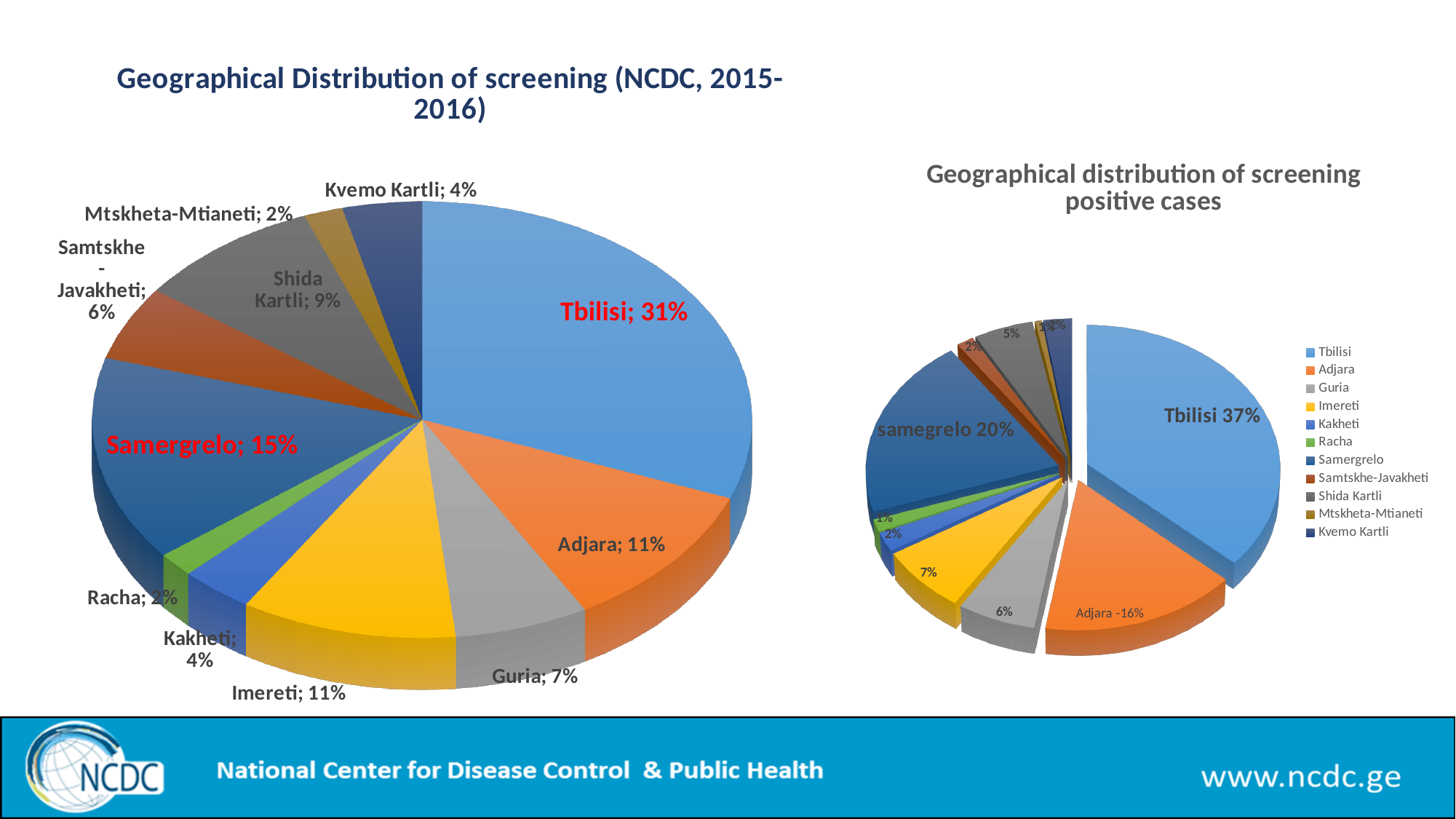
In the left chart, 'Geographical Distribution of screening (NCDC, 2015-2016)', which is larger: the share of Guria or the share of Samtskhe-Javakheti? Guria What kind of chart is the right chart, 'Geographical distribution of screening positive cases'? Pie chart In the left chart, 'Geographical Distribution of screening (NCDC, 2015-2016)', what share does Tbilisi have? 31% In the right chart, 'Geographical distribution of screening positive cases', what share does Tbilisi have? 37% How many entries does the legend of the right chart, 'Geographical distribution of screening positive cases', list? 11 In the left chart, 'Geographical Distribution of screening (NCDC, 2015-2016)', what share does Samergrelo have? 15% In the right chart, 'Geographical distribution of screening positive cases', what share does samegrelo have? 20% In the left chart, 'Geographical Distribution of screening (NCDC, 2015-2016)', what share does Shida Kartli have? 9% In the left chart, 'Geographical Distribution of screening (NCDC, 2015-2016)', what is the difference between the shares of Tbilisi and Samergrelo? 16 percentage points In the right chart, 'Geographical distribution of screening positive cases', what share does Adjara have? 16% How many regions are shown in the left chart, 'Geographical Distribution of screening (NCDC, 2015-2016)'? 11 In the left chart, 'Geographical Distribution of screening (NCDC, 2015-2016)', which region has the largest slice? Tbilisi